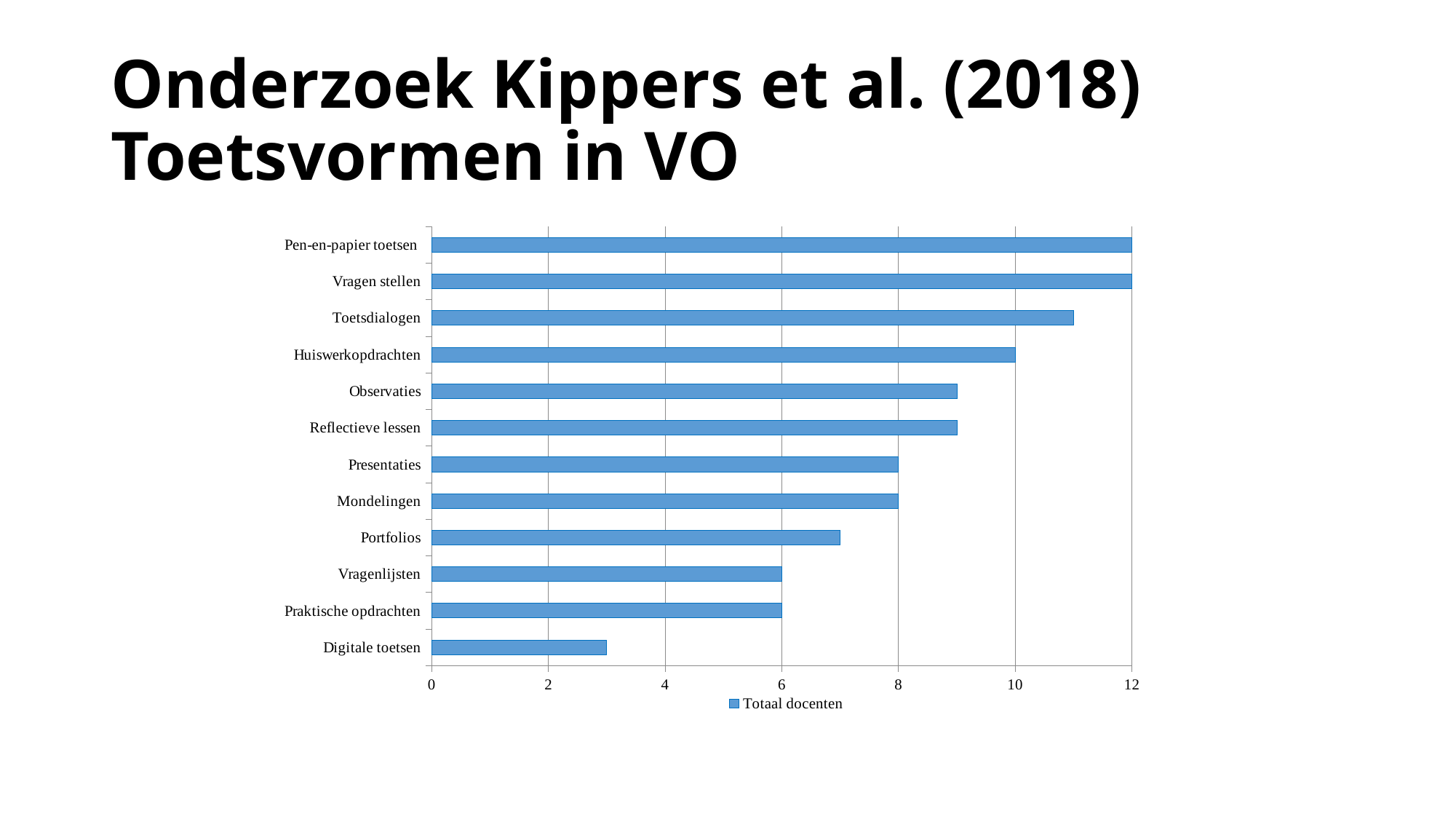
Which is larger, the value for Observaties or the value for Mondelingen? Observaties How many categories are shown in the chart? 12 Is the value for Portfolios greater or less than 6? greater Is the value for Toetsdialogen greater or less than 10? greater What is the value for Pen-en-papier toetsen? 12 What kind of chart is shown on the slide? Bar chart Is the value for Digitale toetsen greater or less than 4? less What is the value for Vragenlijsten? 6 What is the value for Huiswerkopdrachten? 10 Which category has the lowest value? Digitale toetsen What is the difference between the values for Pen-en-papier toetsen and Huiswerkopdrachten? 2 What is the value for Presentaties? 8